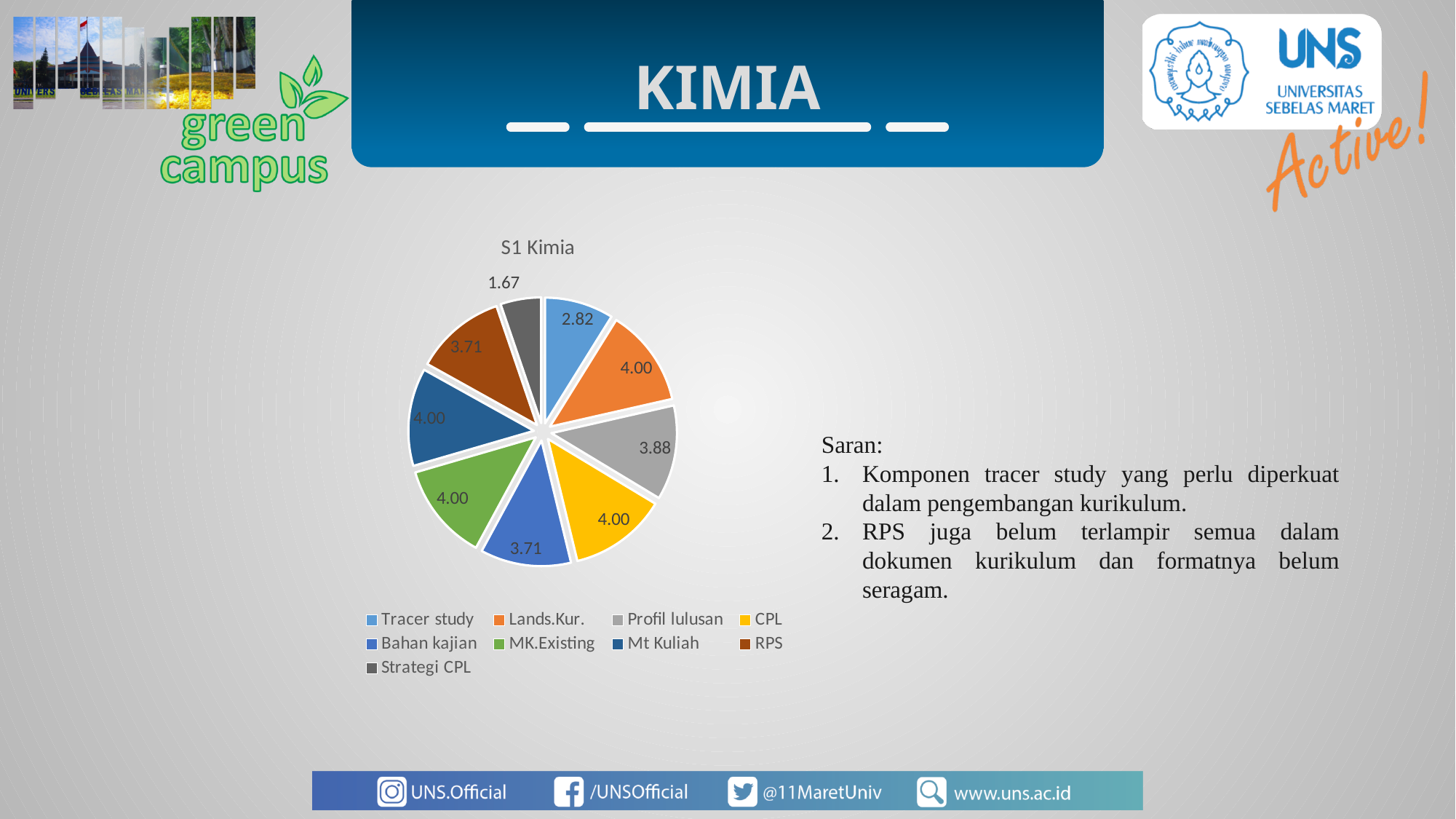
What is the value of the Tracer study slice in the S1 Kimia pie chart? 2.82 What is the value of the Strategi CPL slice in the S1 Kimia pie chart? 1.67 What is the title of the chart on the slide? S1 Kimia What is the value of the Bahan kajian slice in the S1 Kimia pie chart? 3.71 What is the value of the Profil lulusan slice in the S1 Kimia pie chart? 3.88 Which category has the smallest slice in the S1 Kimia pie chart? Strategi CPL What is the difference between the Tracer study value and the Strategi CPL value in the S1 Kimia pie chart? 1.15 What type of chart is shown on the slide? Pie chart What is the difference between the Profil lulusan value and the Bahan kajian value in the S1 Kimia pie chart? 0.17 What is the value of the Lands.Kur. slice in the S1 Kimia pie chart? 4.00 Which is larger in the S1 Kimia pie chart, Tracer study or Profil lulusan? Profil lulusan How many slices does the S1 Kimia pie chart have? 9